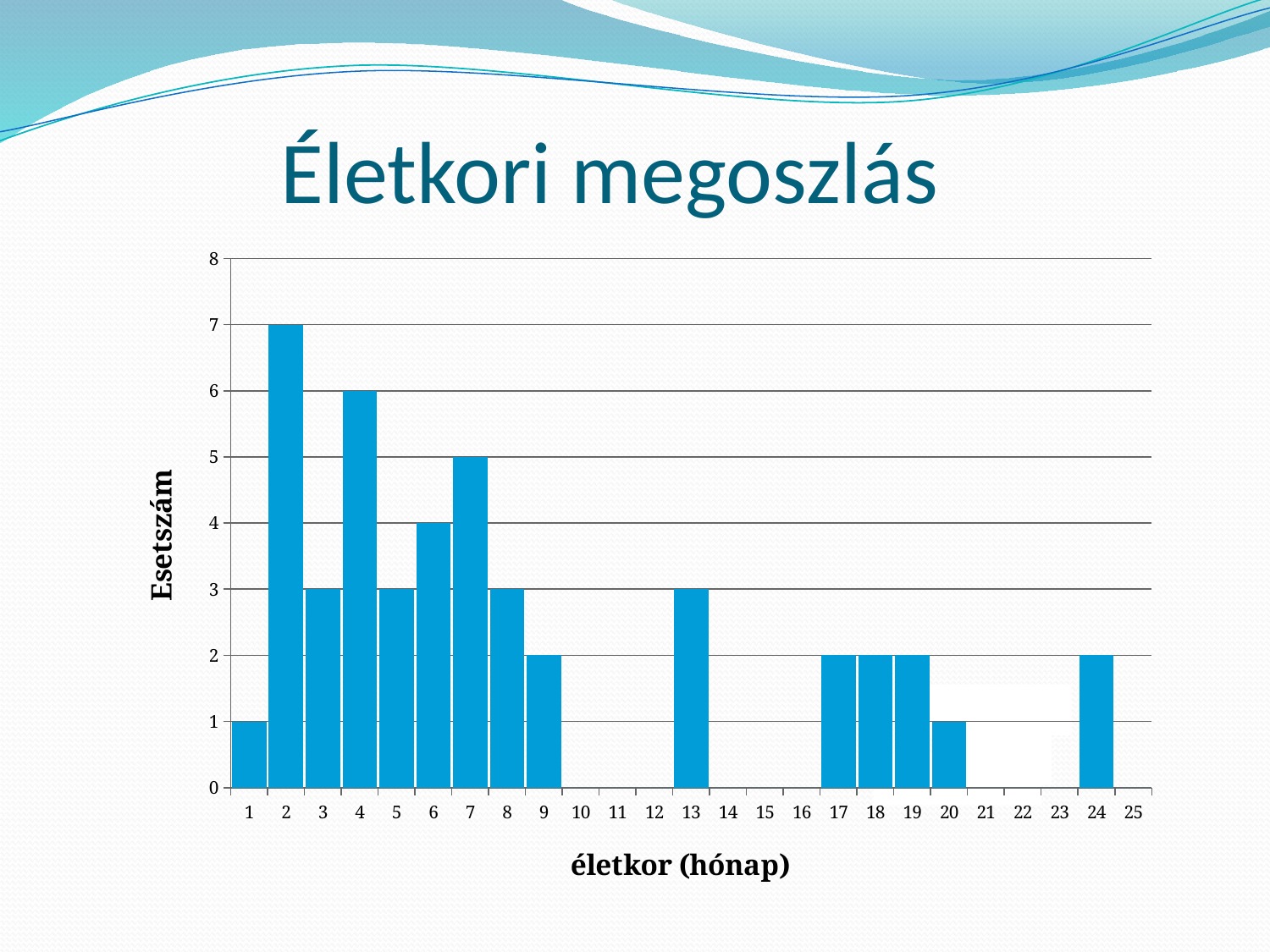
How many age categories (months) are shown on the x axis? 25 What is the number of cases (Esetszám) at age 2 months? 7 Is the value for age 2 months greater or less than 6? greater What is the difference in cases between age 2 months and age 4 months? 1 What is the number of cases at age 7 months? 5 What type of chart is shown on the slide? bar chart What is the title of the chart? Életkori megoszlás Which has more cases, age 6 months or age 9 months? 6 months What is the label of the x axis? életkor (hónap) Which age (in months) has the highest number of cases? 2 What is the number of cases at age 13 months? 3 What is the number of cases at age 4 months? 6